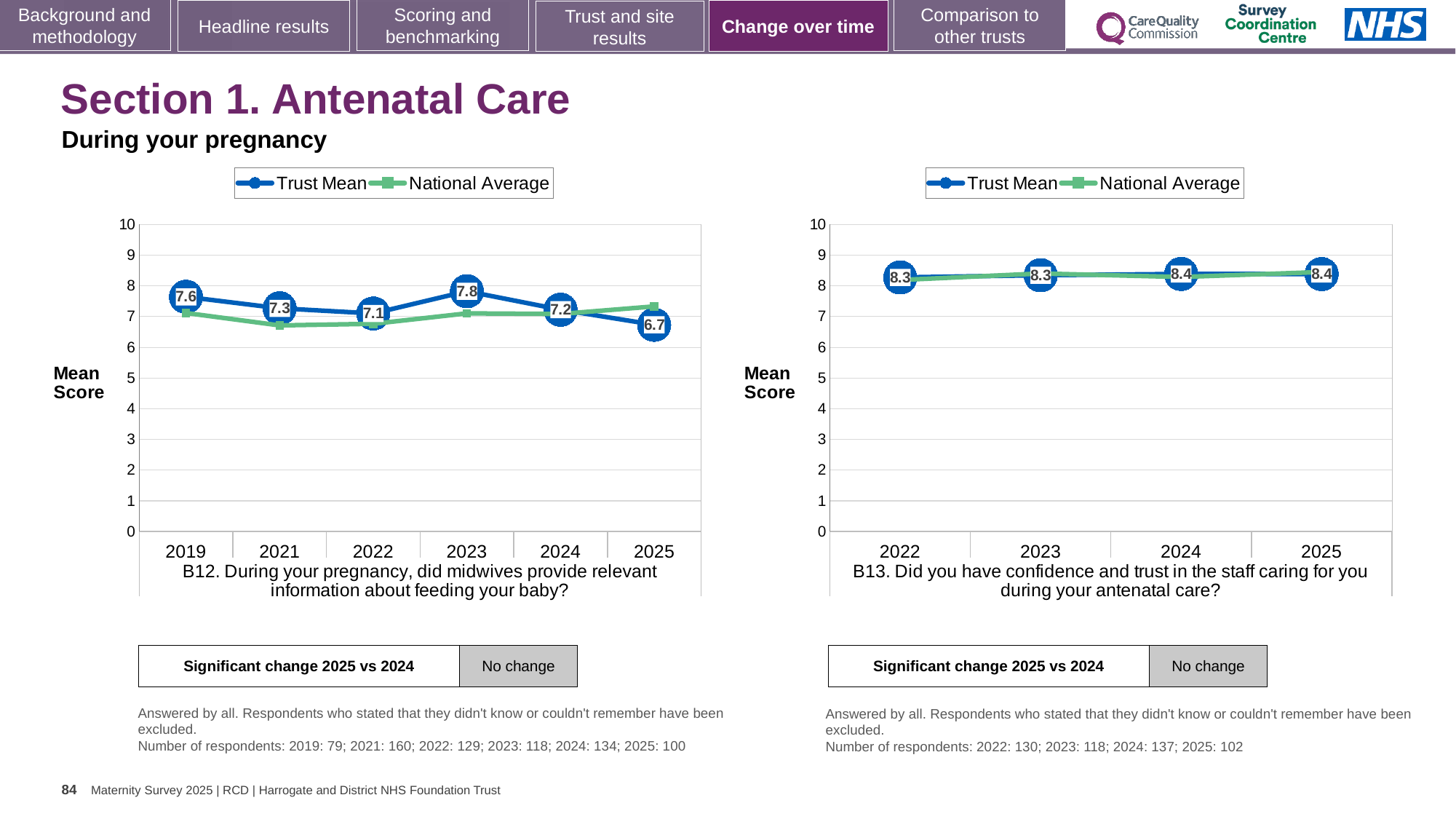
In the B12 chart, is the Trust Mean higher in 2019 or in 2021? 2019 In the B13 chart, what is the difference between the Trust Mean in 2025 and in 2022? 0.1 In the B12 chart, which year has the lowest Trust Mean? 2025 In the B12 chart, is the National Average for 2021 greater or less than 7? less In the B12 chart, what is the Trust Mean for 2023? 7.8 In the B12 chart, which year has the highest Trust Mean? 2023 In the B12 chart, what is the difference between the Trust Mean in 2023 and in 2025? 1.1 In the B13 chart, what is the Trust Mean for 2022? 8.3 In the B12 chart, what is the Trust Mean for 2025? 6.7 What kind of chart is the B13 chart? Line chart How many series does the legend of the B13 chart list? 2 How many years are plotted in the B12 chart? 6